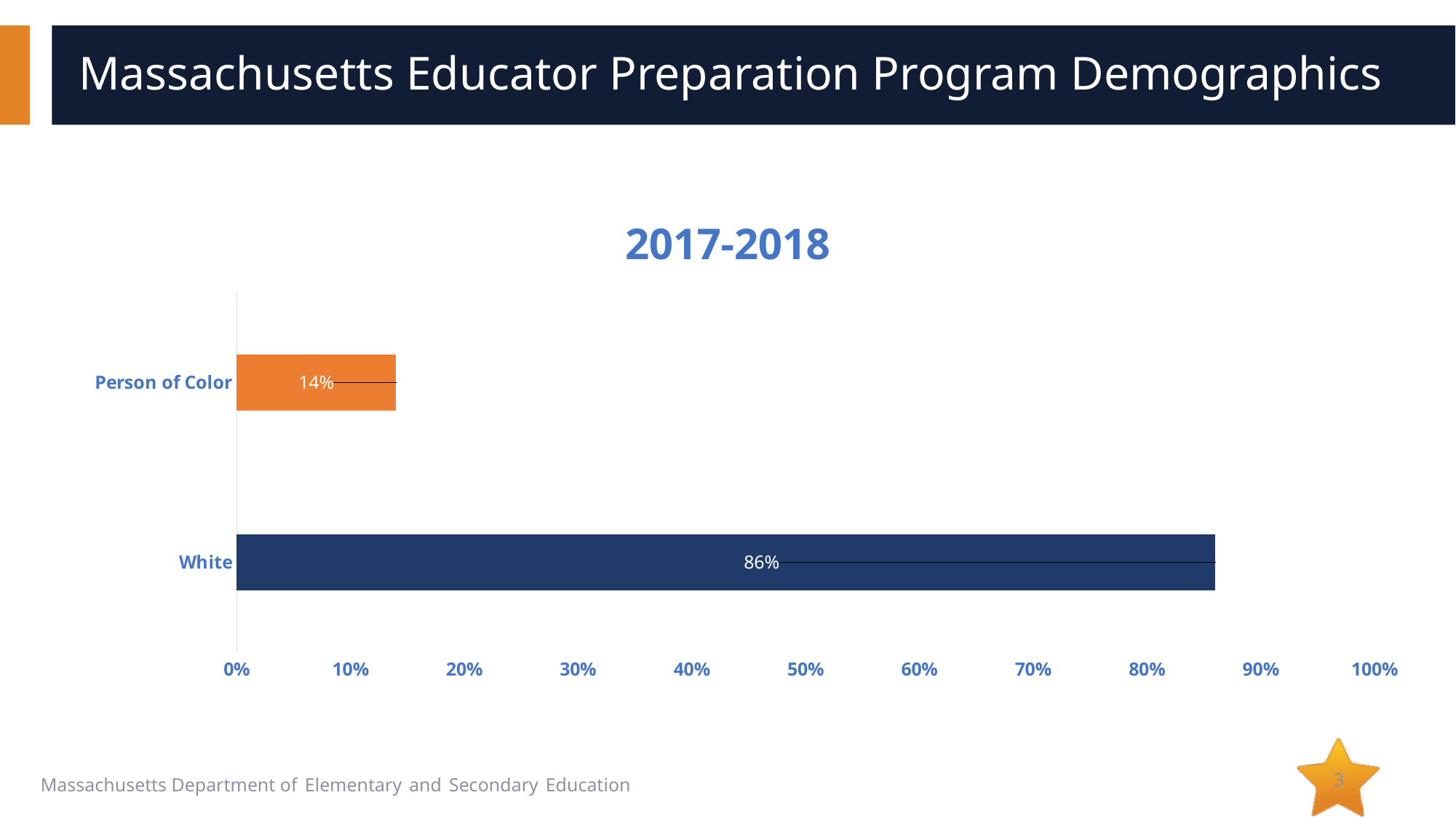
What kind of chart is shown on the slide? bar chart What is the difference between the values for White and Person of Color? 72% Which category has the lowest value? Person of Color What is the value for White? 86% Which is larger, the value for White or the value for Person of Color? White Is the value for White greater or less than 80%? greater Which category has the highest value? White How many categories are shown in the chart? 2 What is the title of the chart? 2017-2018 Is the value for Person of Color greater or less than 20%? less What colour is the bar for Person of Color? orange What is the value for Person of Color? 14%